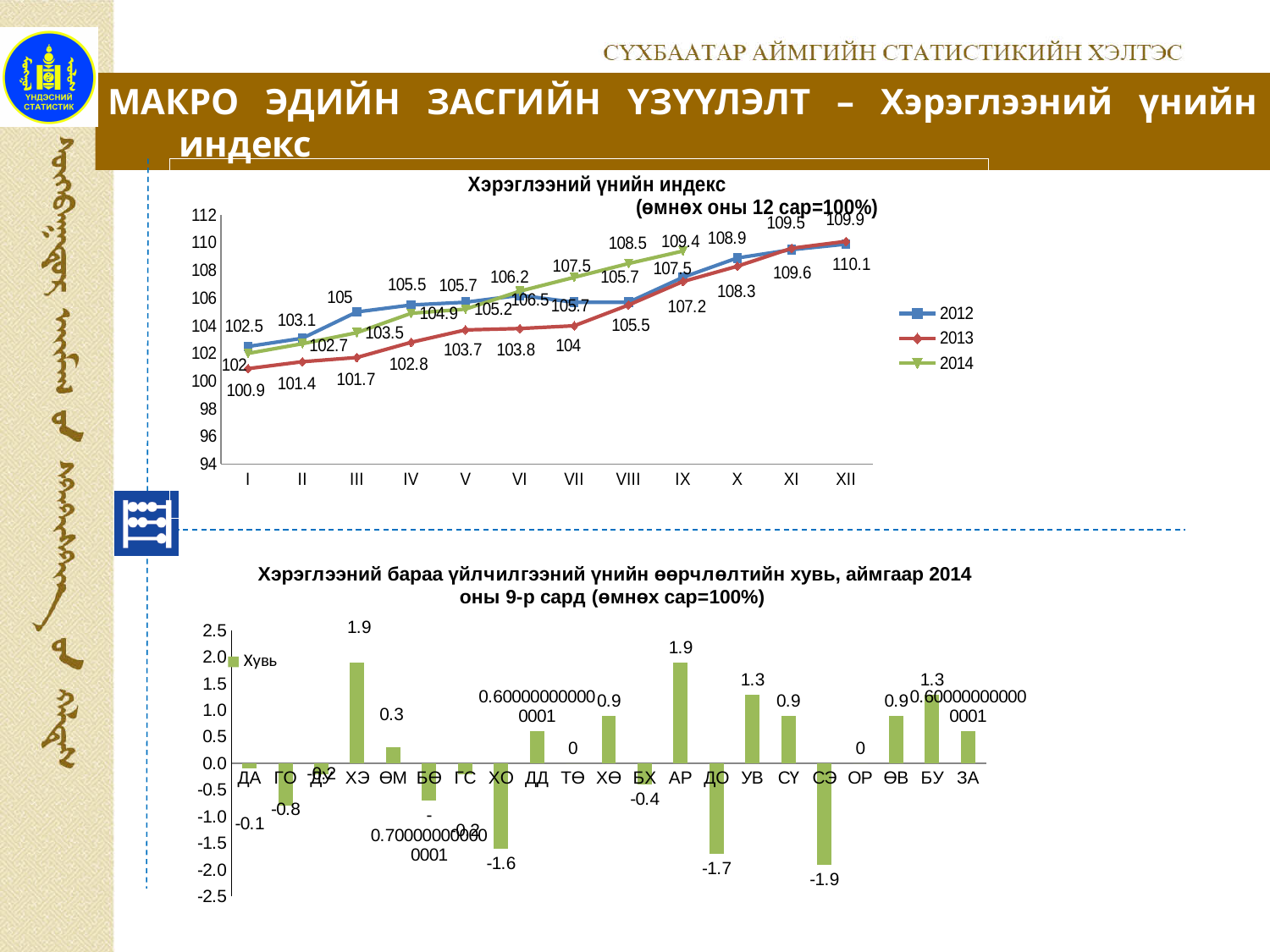
In the bottom chart about price change by aimag in September 2014, what is the value for ДО? -1.7 In the bottom chart about price change by aimag in September 2014, which is larger, the value for УВ or the value for ХӨ? УВ In the top chart 'Хэрэглээний үнийн индекс', what is the value for 2014 in month IX? 109.4 In the top chart 'Хэрэглээний үнийн индекс', what is the difference between the 2013 value in month XII and the 2013 value in month I? 9.2 In the top chart 'Хэрэглээний үнийн индекс', how many series does the legend list? 3 What type of chart is the top chart titled 'Хэрэглээний үнийн индекс'? line chart In the top chart 'Хэрэглээний үнийн индекс', does the 2013 series rise or fall from month I to month XII? rise In the bottom chart about price change by aimag in September 2014, which category has the lowest value? СЭ In the top chart 'Хэрэглээний үнийн индекс', what is the value for 2013 in month XII? 110.1 What type of chart is the bottom chart about price change by aimag in September 2014? bar chart In the bottom chart about price change by aimag in September 2014, how many categories are shown on the x axis? 21 In the top chart 'Хэрэглээний үнийн индекс', what is the value for 2012 in month I? 102.5